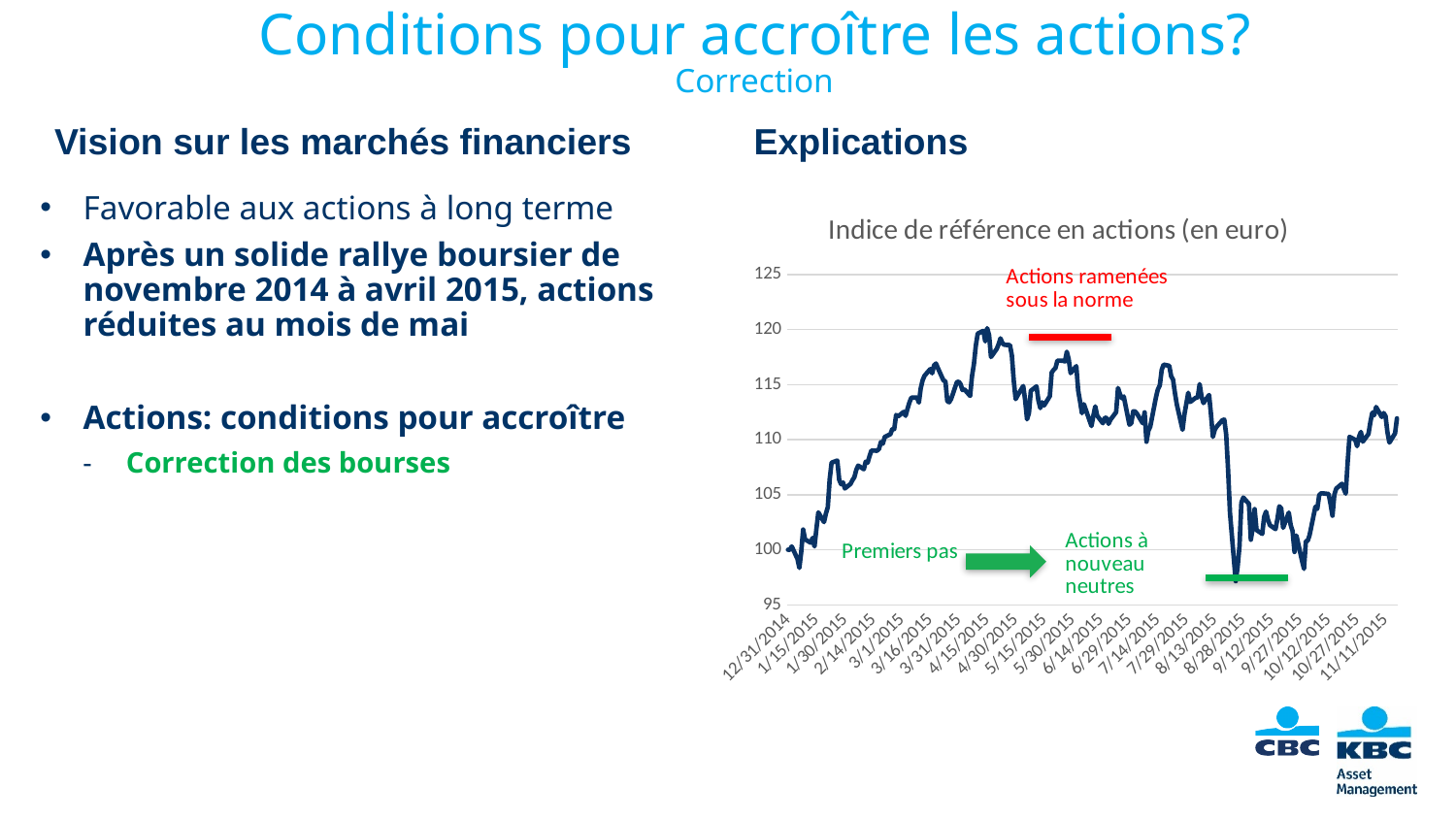
Does the index rise or fall between 12/31/2014 and 4/15/2015? rise Is the value of the index around 11/11/2015 greater or less than 105? greater What is the title of the chart on the slide? Indice de référence en actions (en euro) Does the index rise or fall between 4/15/2015 and 8/28/2015? fall What kind of chart is shown on the slide? line chart What is the highest value shown on the vertical axis of the chart? 125 Which is lower, the index value around 9/27/2015 or around 11/11/2015? 9/27/2015 Is the value of the index around 3/1/2015 greater or less than 115? less Which is higher, the index value around 4/15/2015 or around 8/28/2015? 4/15/2015 How many date labels are shown on the x axis of the chart? 22 Is the value of the index around 4/15/2015 greater or less than 115? greater